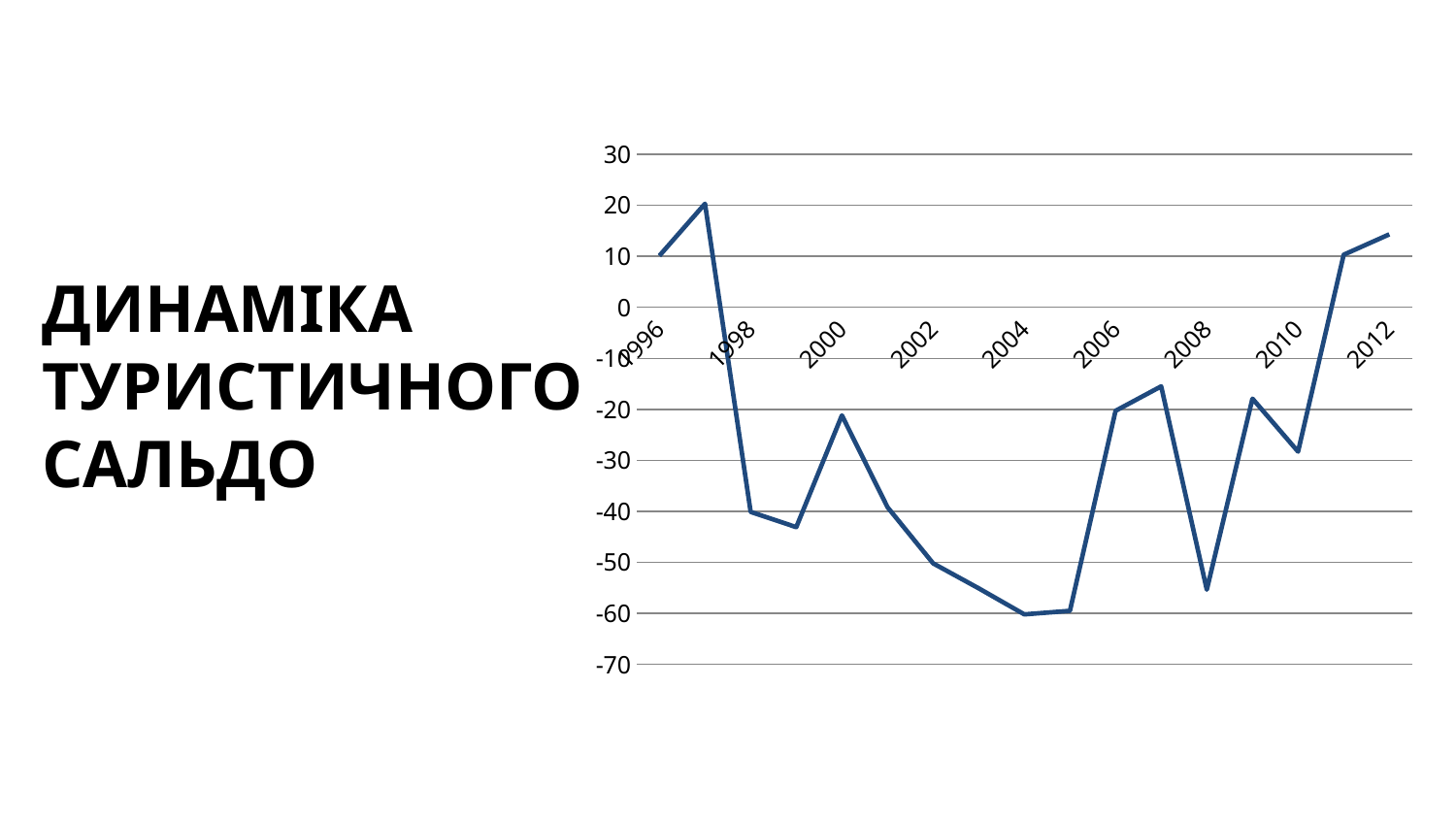
What kind of chart is shown on the slide? line chart Is the value for 2008 greater or less than -50? less How many year labels are shown on the x axis? 9 Which year has the lowest value on the chart? 2004 What is the title shown on the slide next to the chart? ДИНАМІКА ТУРИСТИЧНОГО САЛЬДО Which is larger, the value for 2006 or the value for 2008? 2006 Is the value for 2012 greater or less than 10? greater Is the value for 2000 greater or less than -30? greater Do the values generally rise or fall from 1996 to 2004? fall